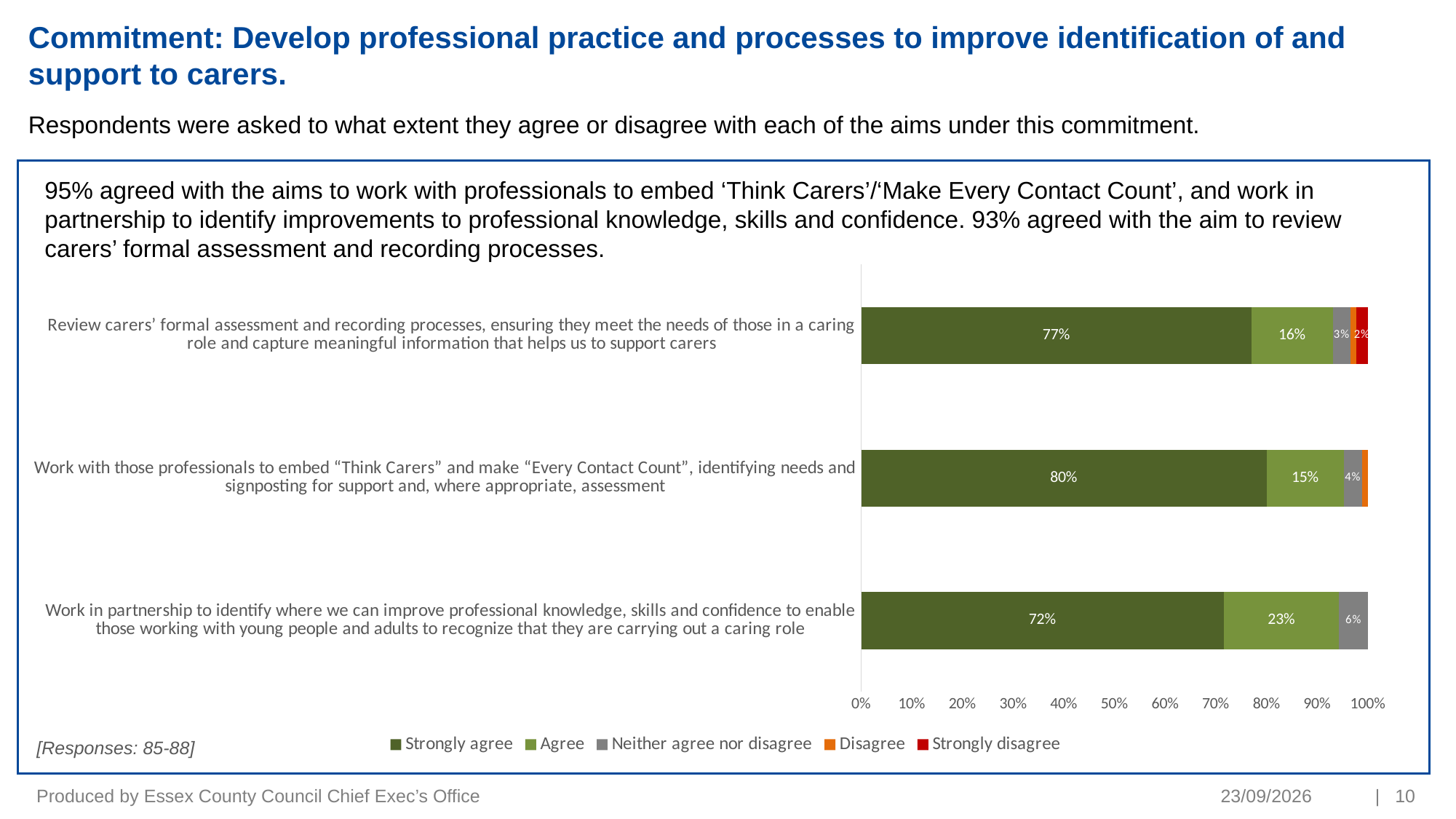
Is the 'Disagree' share for the aim 'Work with those professionals to embed "Think Carers"' greater or less than 10%? less How many response categories does the chart legend list? 5 What percentage of respondents strongly agreed with the aim 'Work with those professionals to embed "Think Carers" and make "Every Contact Count"'? 80% Which aim has a larger 'Agree' share: 'Review carers' formal assessment and recording processes' or 'Work in partnership to identify where we can improve professional knowledge, skills and confidence'? Work in partnership to identify where we can improve professional knowledge, skills and confidence What type of chart is shown on the slide? Stacked bar chart What is the combined 'Strongly agree' and 'Agree' percentage for the aim 'Review carers' formal assessment and recording processes'? 93% What percentage of respondents selected 'Neither agree nor disagree' for the aim 'Review carers' formal assessment and recording processes'? 3% How many aims (categories) are shown in the chart? 3 Which aim has the lowest 'Strongly agree' percentage? Work in partnership to identify where we can improve professional knowledge, skills and confidence What percentage of respondents selected 'Agree' for the aim 'Work in partnership to identify where we can improve professional knowledge, skills and confidence'? 23% How many percentage points higher is the 'Strongly agree' share for the 'Work with those professionals' aim than for the 'Work in partnership' aim? 8 percentage points Which aim has the highest 'Strongly agree' percentage? Work with those professionals to embed "Think Carers" and make "Every Contact Count"